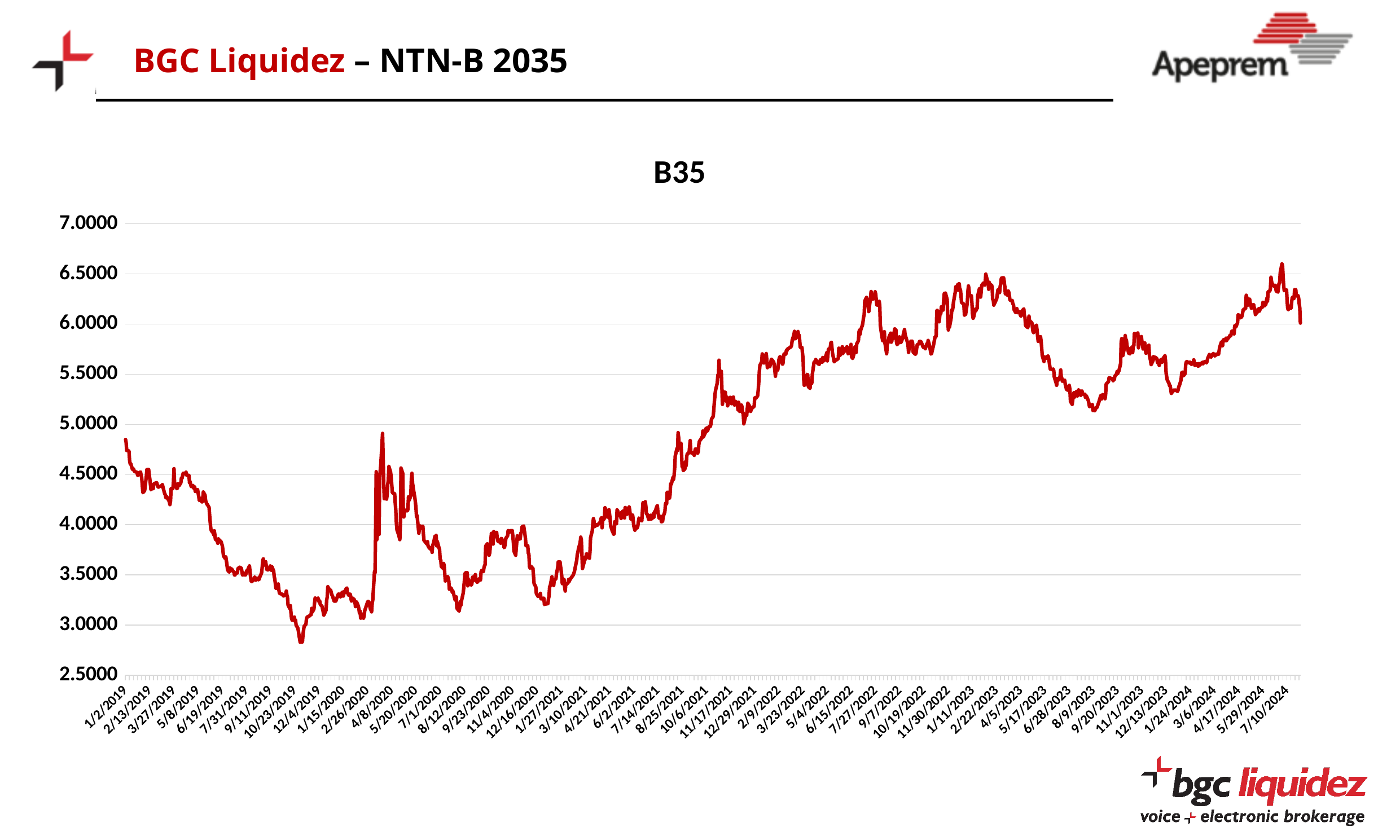
Is the value at 8/9/2023 greater or less than 5.0000? greater In which year does the B35 line reach its lowest point? 2019 In which year does the B35 line reach its highest point? 2024 Is the value at 2/22/2023 greater or less than 6.0000? greater Is the value at 1/2/2019 greater or less than 5.0000? less Overall, does the B35 line rise or fall from the start of 2019 to mid-2024? rise What kind of chart is shown on the slide? line chart What is the title of the chart? B35 Is the value at 1/2/2019 larger or smaller than the value at 2/22/2023? smaller What colour is the line in the B35 chart? red